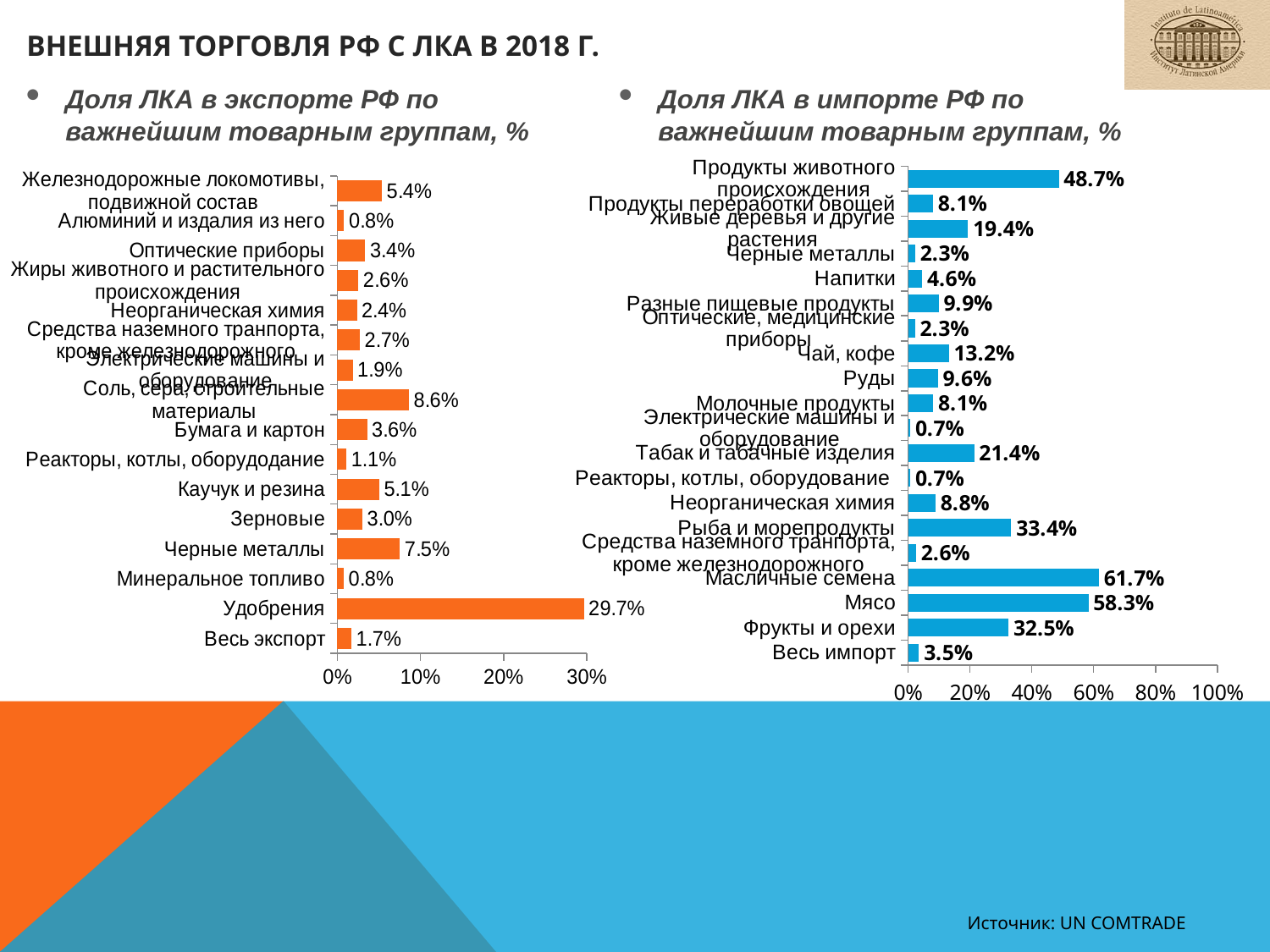
In the left chart (share of LCA in Russian exports), which category has the highest value? Удобрения In the right chart (share of LCA in Russian imports), what is the difference between Рыба и морепродукты and Фрукты и орехи? 0.9% In the left chart (share of LCA in Russian exports), which is larger: Каучук и резина or Зерновые? Каучук и резина In the right chart (share of LCA in Russian imports), which is larger: Табак и табачные изделия or Чай, кофе? Табак и табачные изделия How many categories are plotted in the right chart (share of LCA in Russian imports)? 20 In the left chart (share of LCA in Russian exports), what is the value for Черные металлы? 7.5% In the left chart (share of LCA in Russian exports), what is the value for Удобрения? 29.7% In the right chart (share of LCA in Russian imports), what is the value for Мясо? 58.3% In the right chart (share of LCA in Russian imports), which category has the highest value? Масличные семена In the right chart (share of LCA in Russian imports), what is the value for Весь импорт? 3.5% In the left chart (share of LCA in Russian exports), what is the difference between Соль, сера, строительные материалы and Бумага и картон? 5.0% What type of chart is used on the left side of the slide? Bar chart